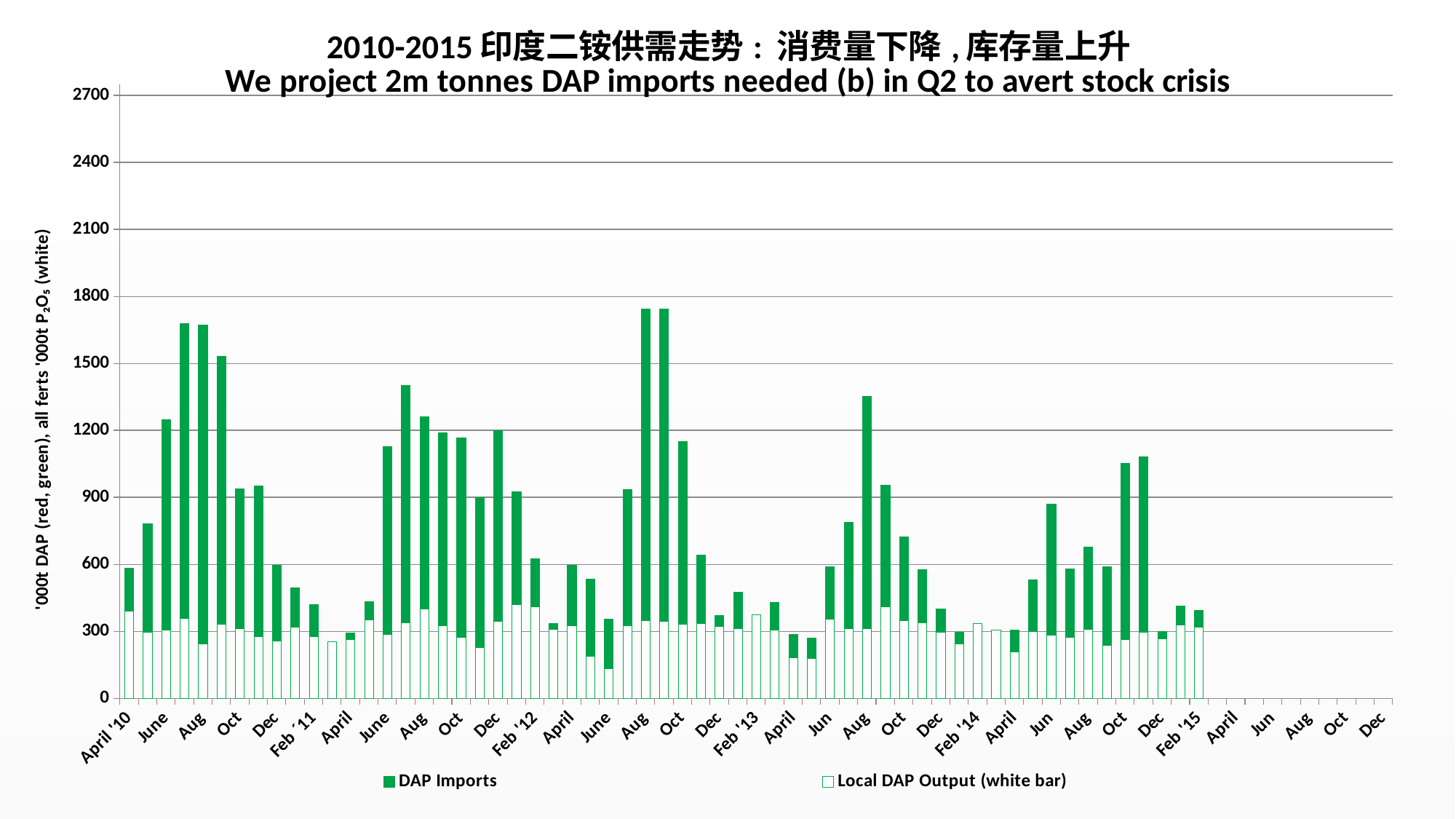
Is the DAP Imports value for Dec '13 greater or less than 600? less What kind of chart is shown on the slide? bar chart What are the two series named in the legend? DAP Imports; Local DAP Output (white bar) What is the English subtitle of the chart? We project 2m tonnes DAP imports needed (b) in Q2 to avert stock crisis Is the DAP Imports value for Feb '15 greater or less than 600? less Do the DAP Imports values rise or fall from April '10 to Aug '10? rise Which is larger, the DAP Imports value for Aug '12 or for Aug '13? Aug '12 How many series does the legend list? 2 Which is larger, the DAP Imports value for Aug '10 or for Aug '11? Aug '10